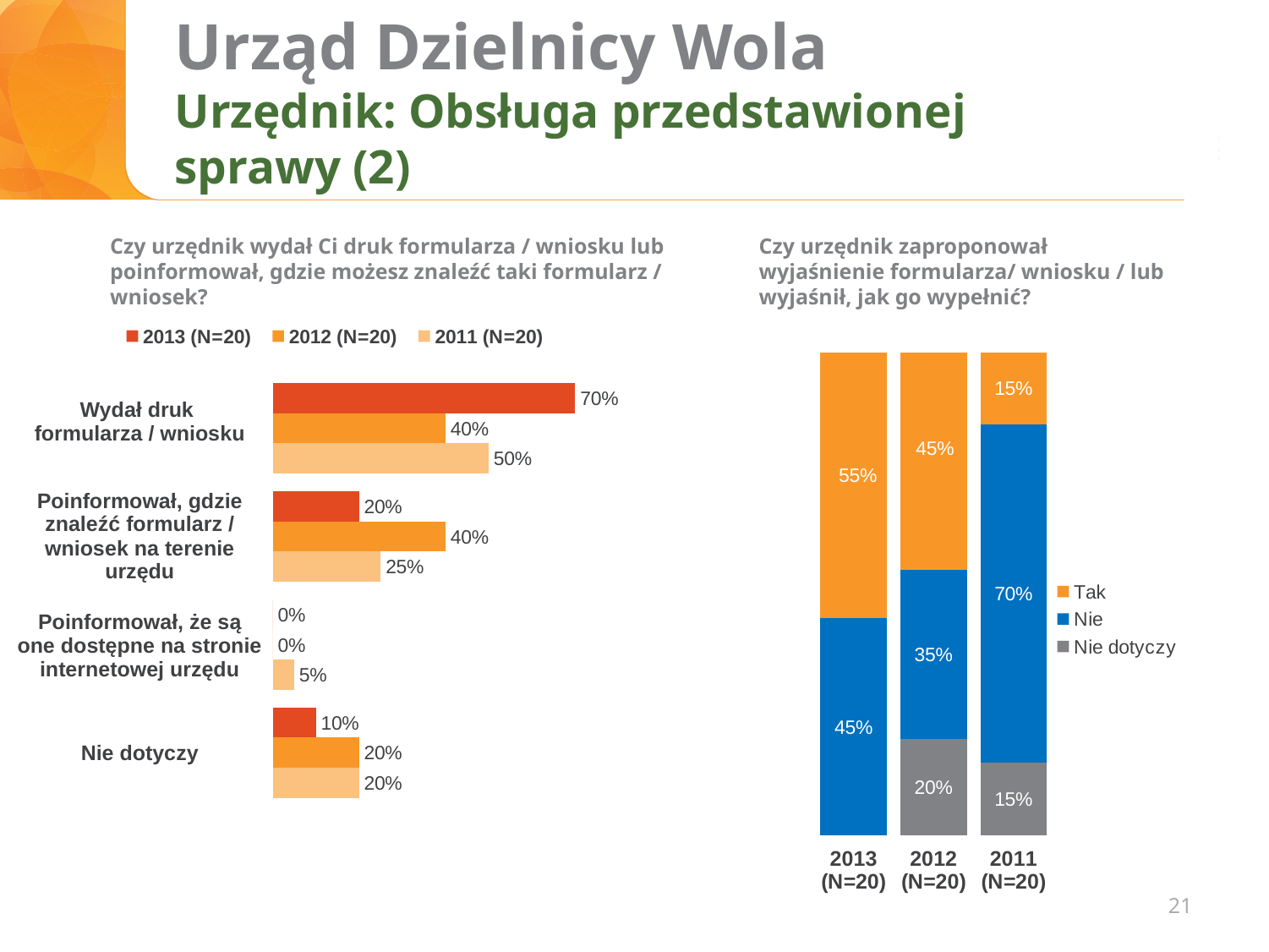
What kind of chart is the right chart (Czy urzędnik zaproponował wyjaśnienie formularza...)? Stacked bar chart In the left chart (Czy urzędnik wydał Ci druk formularza...), how many categories are shown? 4 In the right chart (Czy urzędnik zaproponował wyjaśnienie formularza...), which year has the lowest 'Tak' value? 2011 (N=20) In the left chart (Czy urzędnik wydał Ci druk formularza...), what is the 2011 (N=20) value for 'Poinformował, gdzie znaleźć formularz / wniosek na terenie urzędu'? 25% In the right chart (Czy urzędnik zaproponował wyjaśnienie formularza...), what is the 'Nie' value for 2011 (N=20)? 70% In the left chart (Czy urzędnik wydał Ci druk formularza...), what is the 2013 (N=20) value for 'Wydał druk formularza / wniosku'? 70% In the right chart (Czy urzędnik zaproponował wyjaśnienie formularza...), what is the 'Tak' value for 2013 (N=20)? 55% In the right chart (Czy urzędnik zaproponował wyjaśnienie formularza...), is the 'Nie dotyczy' value for 2012 larger or smaller than for 2011? Larger In the left chart (Czy urzędnik wydał Ci druk formularza...), what is the difference between the 2013 and 2012 values for 'Wydał druk formularza / wniosku'? 30% In the left chart (Czy urzędnik wydał Ci druk formularza...), what is the 2011 (N=20) value for 'Poinformował, że są one dostępne na stronie internetowej urzędu'? 5% In the left chart (Czy urzędnik wydał Ci druk formularza...), how many series does the legend list? 3 In the left chart (Czy urzędnik wydał Ci druk formularza...), which category has the highest 2013 (N=20) value? Wydał druk formularza / wniosku